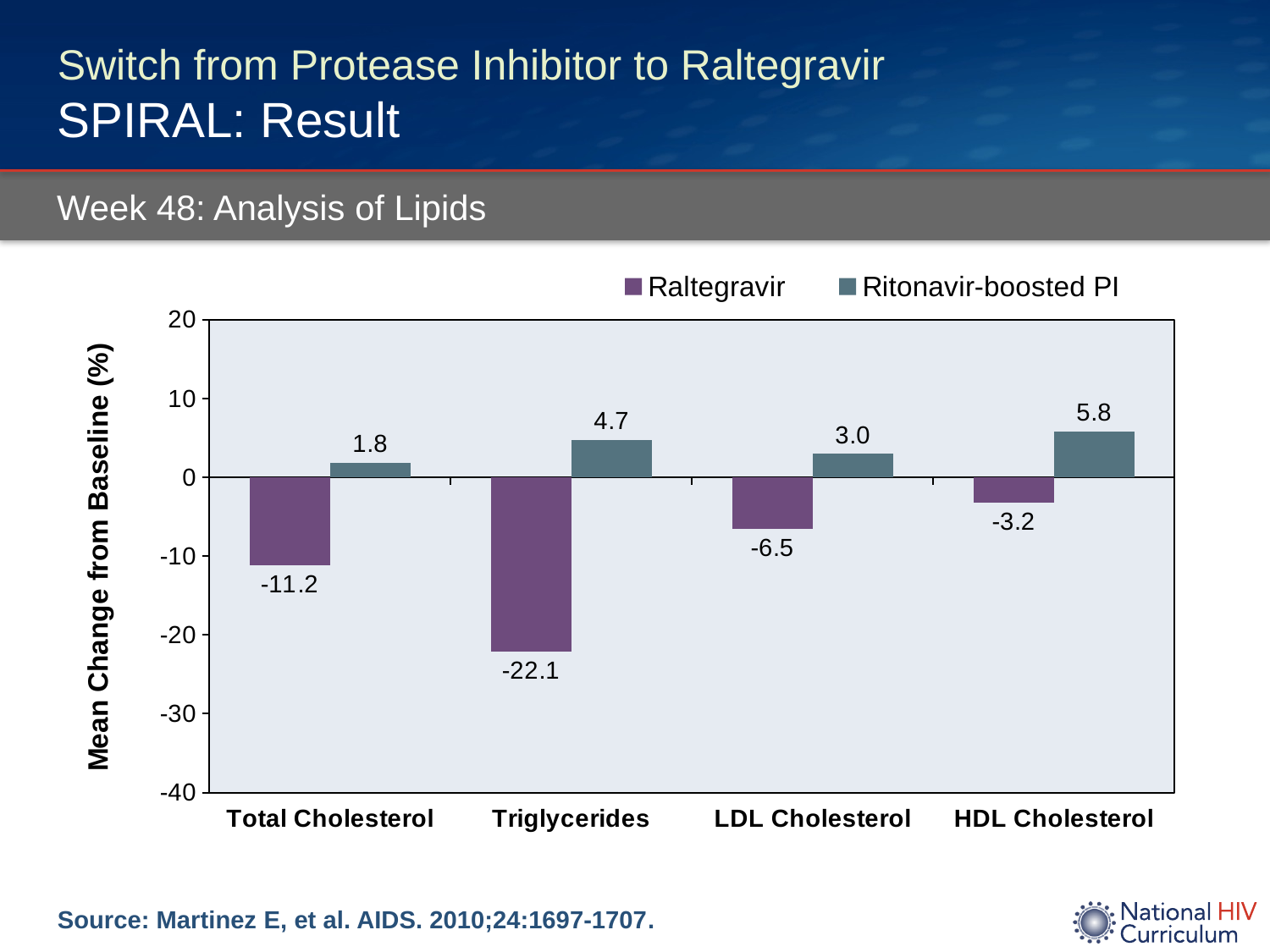
What is the mean change from baseline for Ritonavir-boosted PI in Triglycerides? 4.7 Which lipid category has the lowest value for Raltegravir? Triglycerides What kind of chart is shown on the slide? Bar chart Which lipid category has the highest value for Ritonavir-boosted PI? HDL Cholesterol What is the mean change from baseline for Raltegravir in HDL Cholesterol? -3.2 How many lipid categories are shown on the x axis? 4 Which is larger for LDL Cholesterol: the Raltegravir value or the Ritonavir-boosted PI value? Ritonavir-boosted PI What is the difference between the Ritonavir-boosted PI and Raltegravir values for Triglycerides? 26.8 What is the mean change from baseline for Raltegravir in Total Cholesterol? -11.2 What is the mean change from baseline for Ritonavir-boosted PI in LDL Cholesterol? 3.0 How many series does the legend list? 2 What is the label of the y axis? Mean Change from Baseline (%)